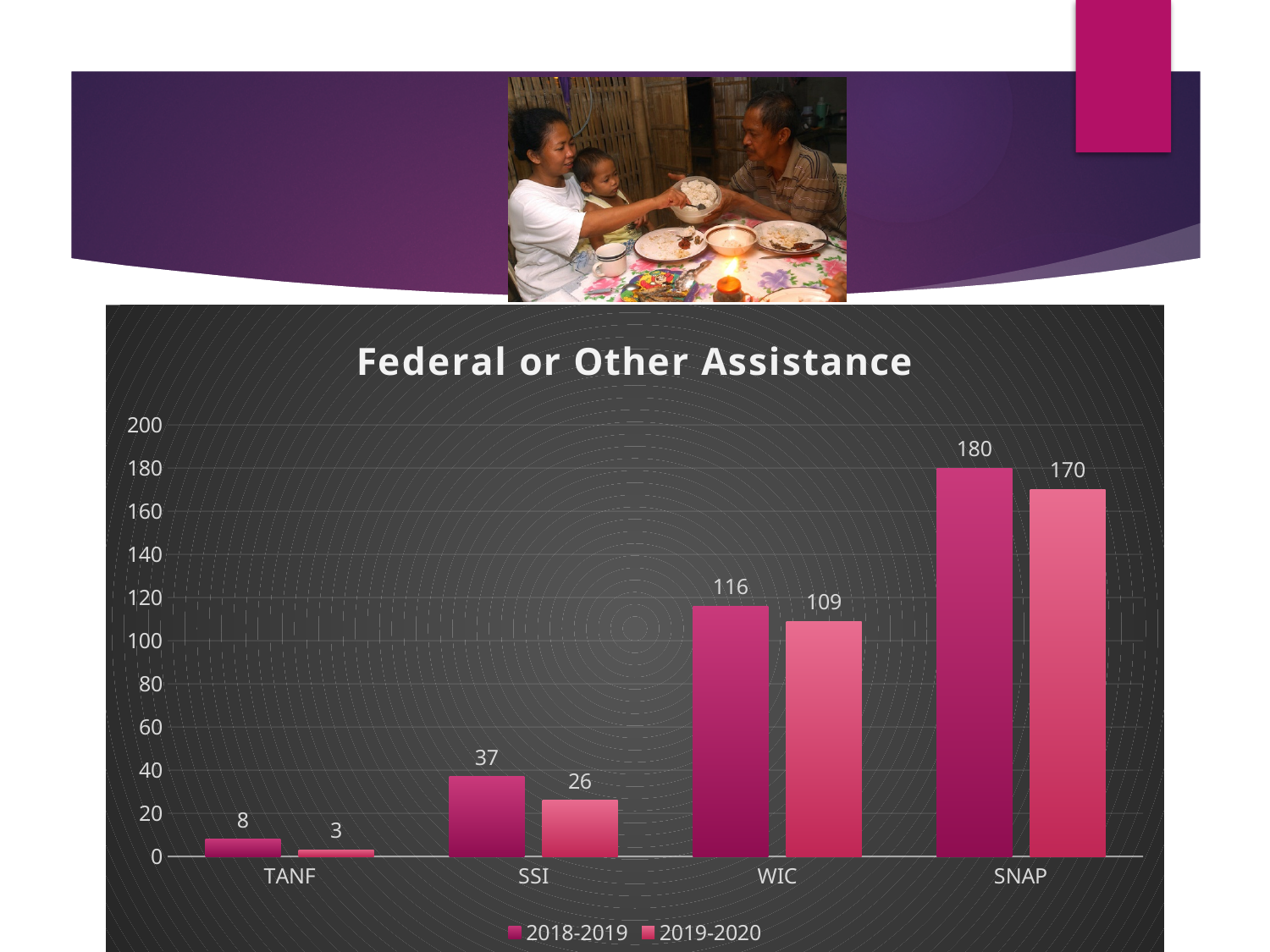
Which category has the lowest value in the 2019-2020 series? TANF What is the value for WIC in the 2019-2020 series? 109 What is the title of the chart? Federal or Other Assistance How many categories are shown on the x axis? 4 How many series does the legend list? 2 Which is larger, the 2018-2019 value for WIC or the 2019-2020 value for WIC? 2018-2019 What is the difference between the 2018-2019 and 2019-2020 values for SNAP? 10 What kind of chart is shown on the slide? bar chart Which category has the highest value in the 2018-2019 series? SNAP What is the value for TANF in the 2019-2020 series? 3 What is the difference between the 2018-2019 and 2019-2020 values for SSI? 11 What is the value for SNAP in the 2018-2019 series? 180